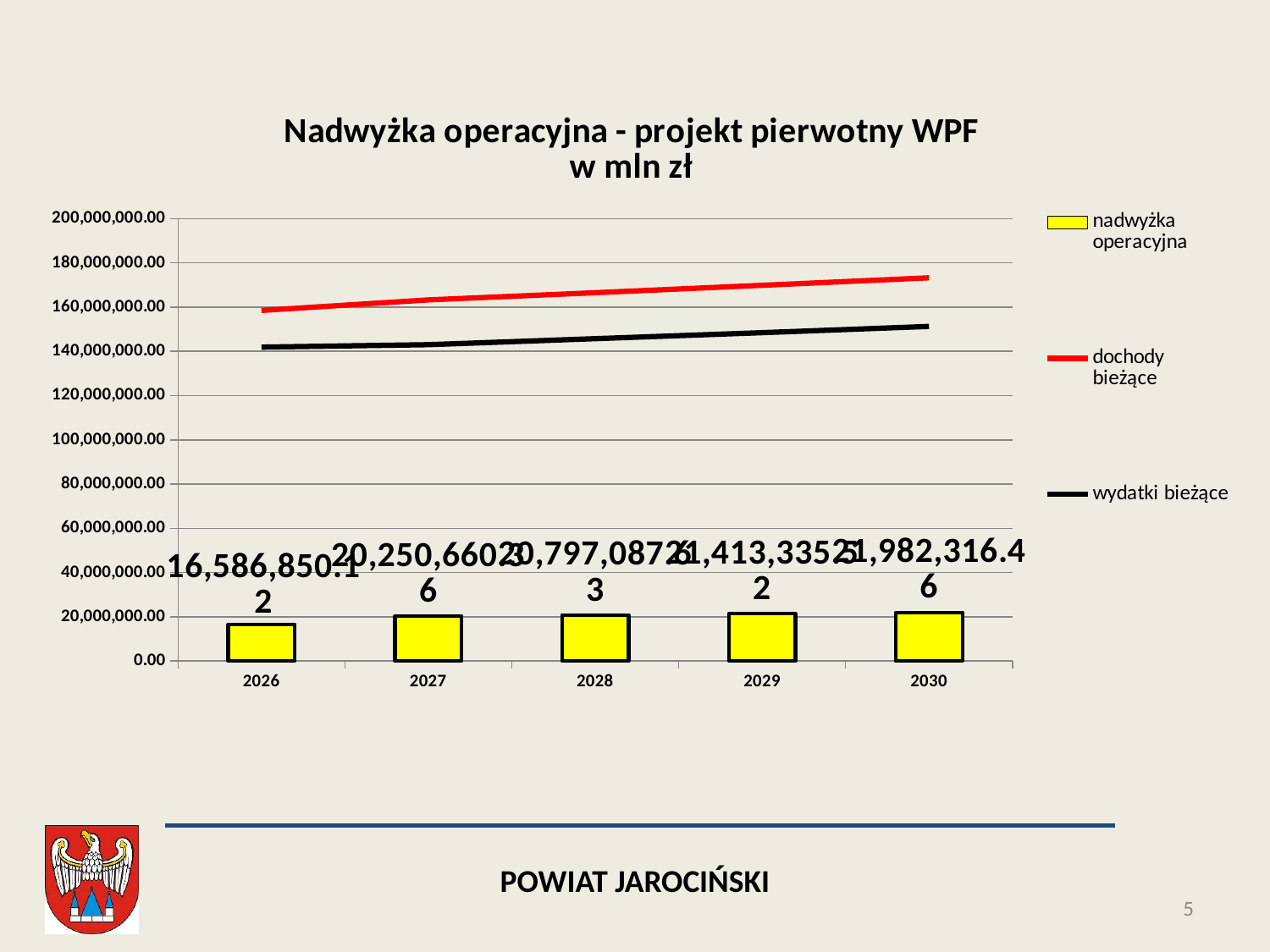
What is the value of nadwyżka operacyjna for 2026? 16,586,850.12 In 2030, which is larger: dochody bieżące or wydatki bieżące? dochody bieżące How many years are shown on the x axis? 5 Does nadwyżka operacyjna rise or fall from 2026 to 2030? rise Is the value of wydatki bieżące in 2030 greater or less than 160,000,000.00? less What is the difference between nadwyżka operacyjna in 2030 and in 2026? 5,395,466.34 How many series does the legend list? 3 Which year has the highest nadwyżka operacyjna? 2030 What is the value of nadwyżka operacyjna for 2030? 21,982,316.46 Is the value of dochody bieżące in 2030 greater or less than 160,000,000.00? greater Which year has the lowest nadwyżka operacyjna? 2026 What kind of chart is this? Combined bar and line chart